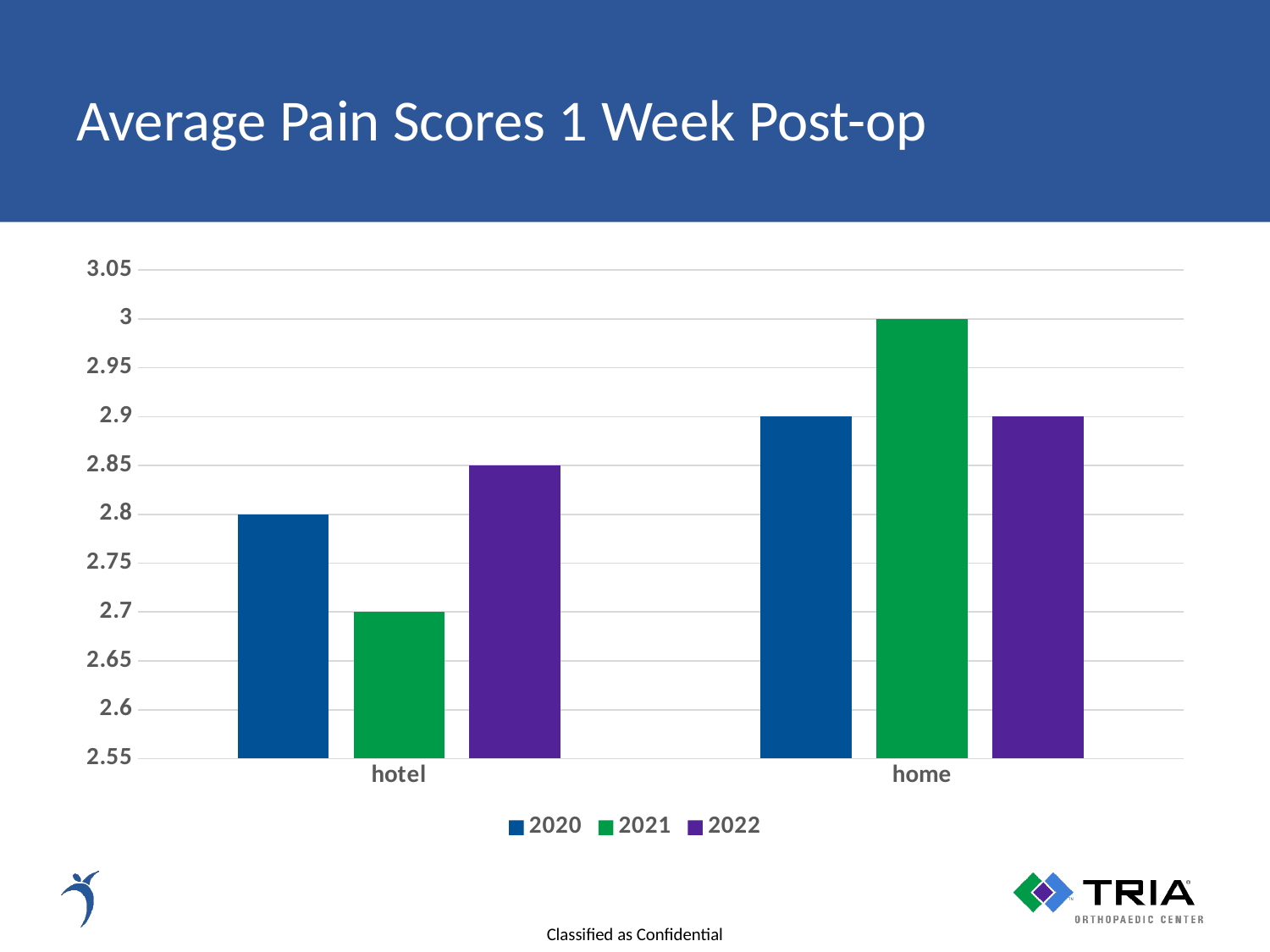
What is the difference between the 2021 values for home and hotel? 0.3 Which series has the lowest value for hotel? 2021 What is the 2022 value for hotel? 2.85 What is the 2021 value for hotel? 2.7 What is the title of the chart? Average Pain Scores 1 Week Post-op What is the 2020 value for home? 2.9 Which series has the highest value for home? 2021 Which is larger, the 2020 value for hotel or the 2020 value for home? home What kind of chart is shown on the slide? bar chart How many series does the legend list? 3 How many categories are shown on the x axis? 2 What is the 2021 value for home? 3